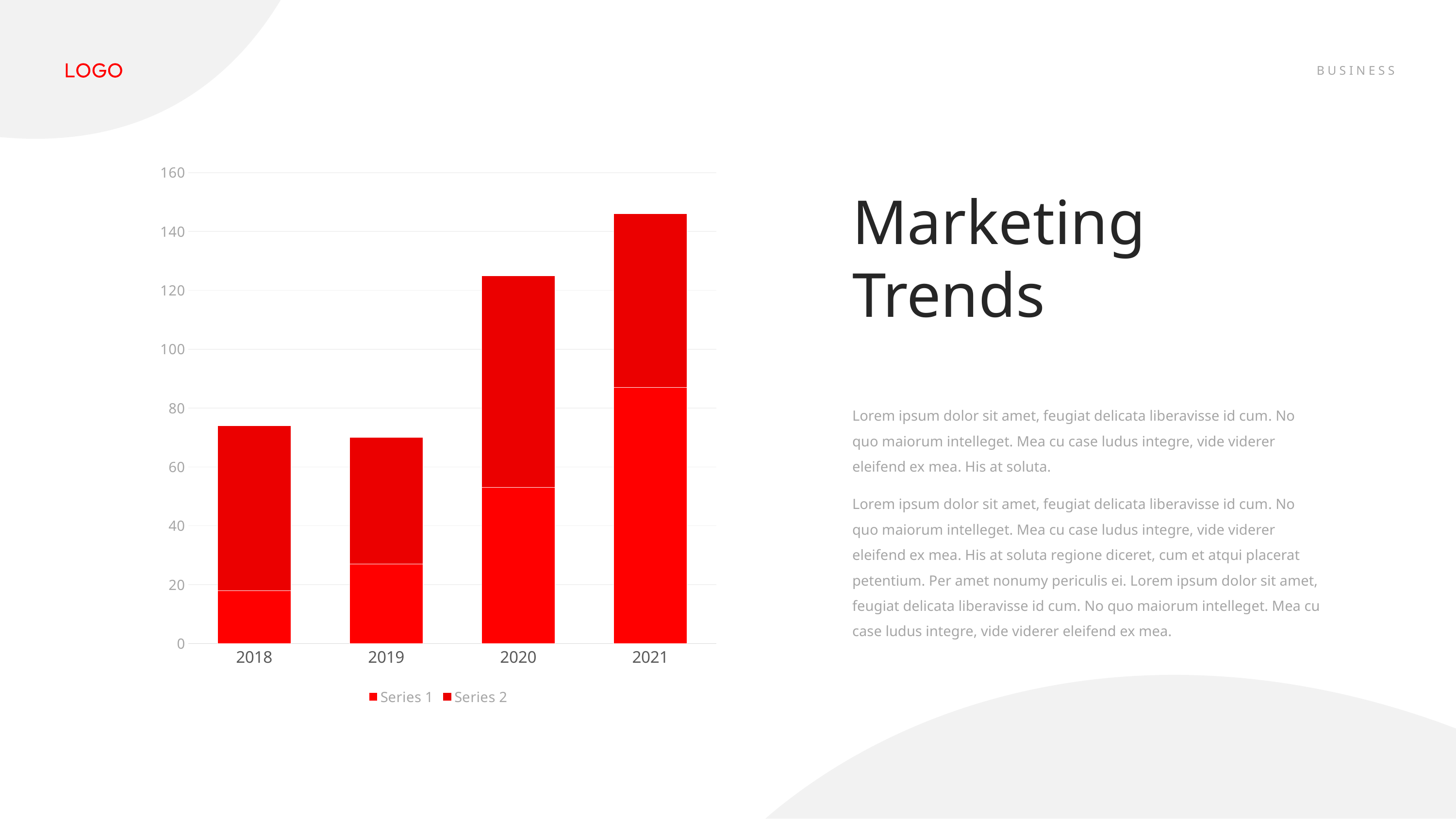
Which year has the smallest Series 1 value in the chart? 2018 How many categories are shown on the x axis of the chart? 4 How many series does the chart legend list? 2 Is the total stacked value for 2018 greater or less than 80? less Is the Series 1 value for 2020 greater or less than 40? greater Which year has the larger total stacked value, 2019 or 2020? 2020 What kind of chart is shown on the slide? stacked bar chart Which year has the largest Series 1 value in the chart? 2021 Does the Series 1 value rise or fall from 2018 to 2021? rise Is the total stacked value for 2021 greater or less than 140? greater Which year has the tallest stacked bar in the chart? 2021